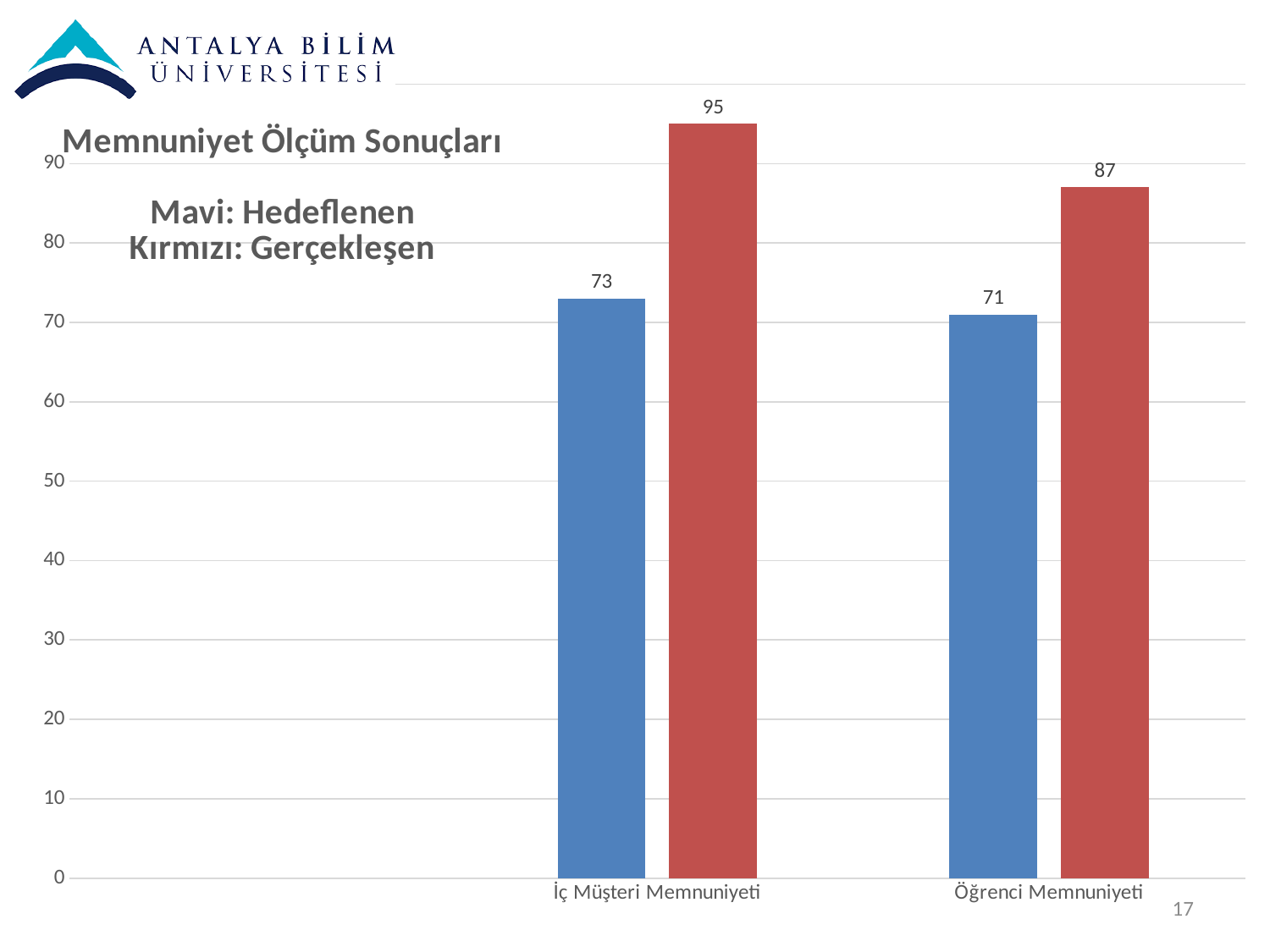
What is the difference between the Gerçekleşen and Hedeflenen values for Öğrenci Memnuniyeti? 16 What is the Gerçekleşen (red) value for Öğrenci Memnuniyeti? 87 How many categories are shown on the x axis? 2 Which is larger: the Gerçekleşen value for İç Müşteri Memnuniyeti or the Gerçekleşen value for Öğrenci Memnuniyeti? İç Müşteri Memnuniyeti What kind of chart is shown on the slide? Bar chart Which bar has the highest value on the chart? Gerçekleşen for İç Müşteri Memnuniyeti What is the Hedeflenen (blue) value for İç Müşteri Memnuniyeti? 73 Which bar has the lowest value on the chart? Hedeflenen for Öğrenci Memnuniyeti What is the difference between the Gerçekleşen and Hedeflenen values for İç Müşteri Memnuniyeti? 22 What is the title of the chart? Memnuniyet Ölçüm Sonuçları What is the Hedeflenen (blue) value for Öğrenci Memnuniyeti? 71 What is the Gerçekleşen (red) value for İç Müşteri Memnuniyeti? 95